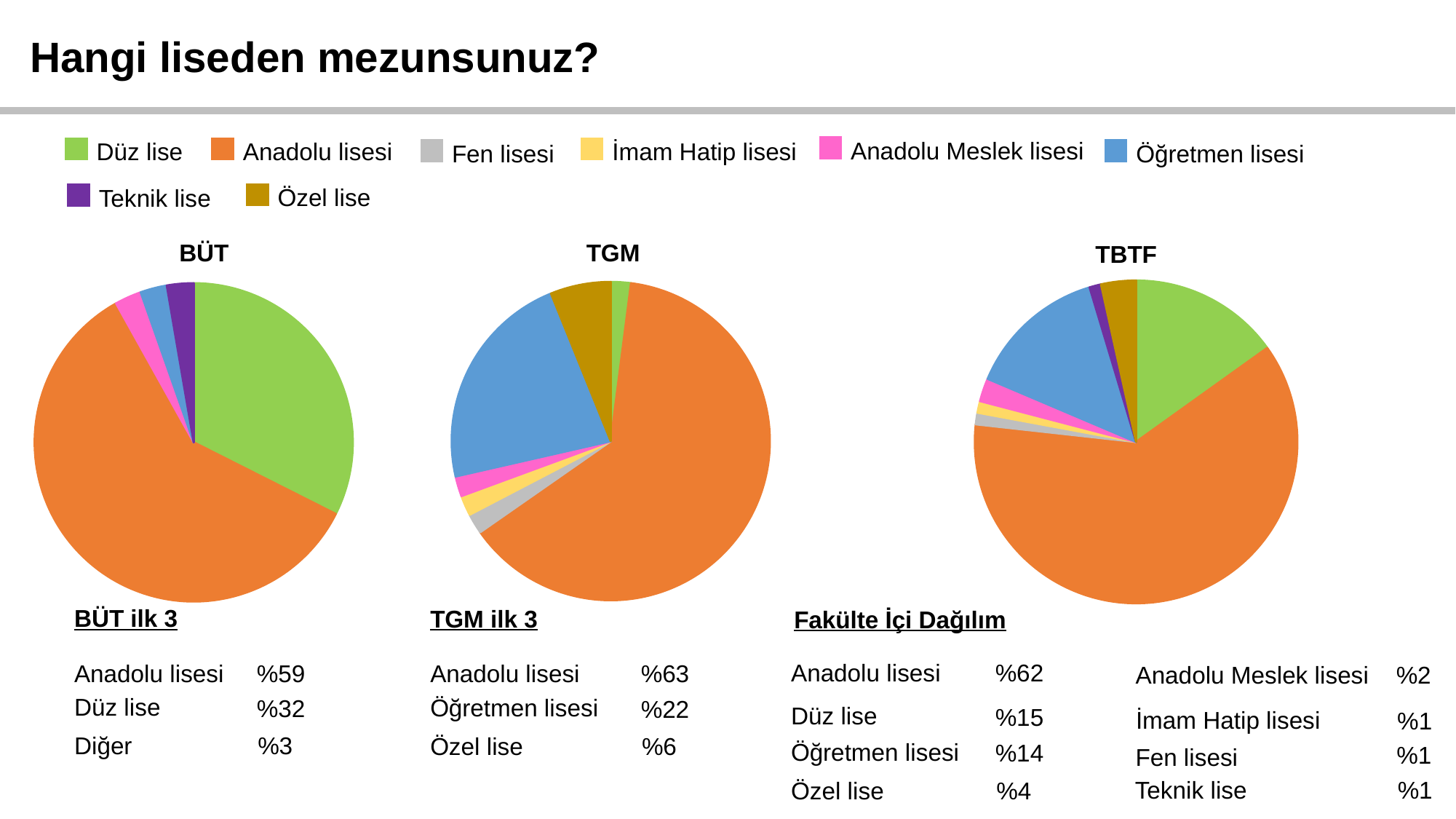
In the BÜT chart, what share does Anadolu lisesi have? %59 How many pie charts are shown on the slide? 3 What type of chart is the BÜT chart? pie chart Which colour represents Öğretmen lisesi in the legend? blue In the TGM chart, which category has the largest slice? Anadolu lisesi In the TGM chart, what share does Öğretmen lisesi have? %22 In the BÜT chart, what share does Düz lise have? %32 What is the difference between the Anadolu lisesi share in the TGM chart (%63) and in the BÜT chart (%59)? 4 percentage points How many entries does the shared legend list? 8 In the BÜT chart, which is larger, the Düz lise slice or the Anadolu lisesi slice? Anadolu lisesi